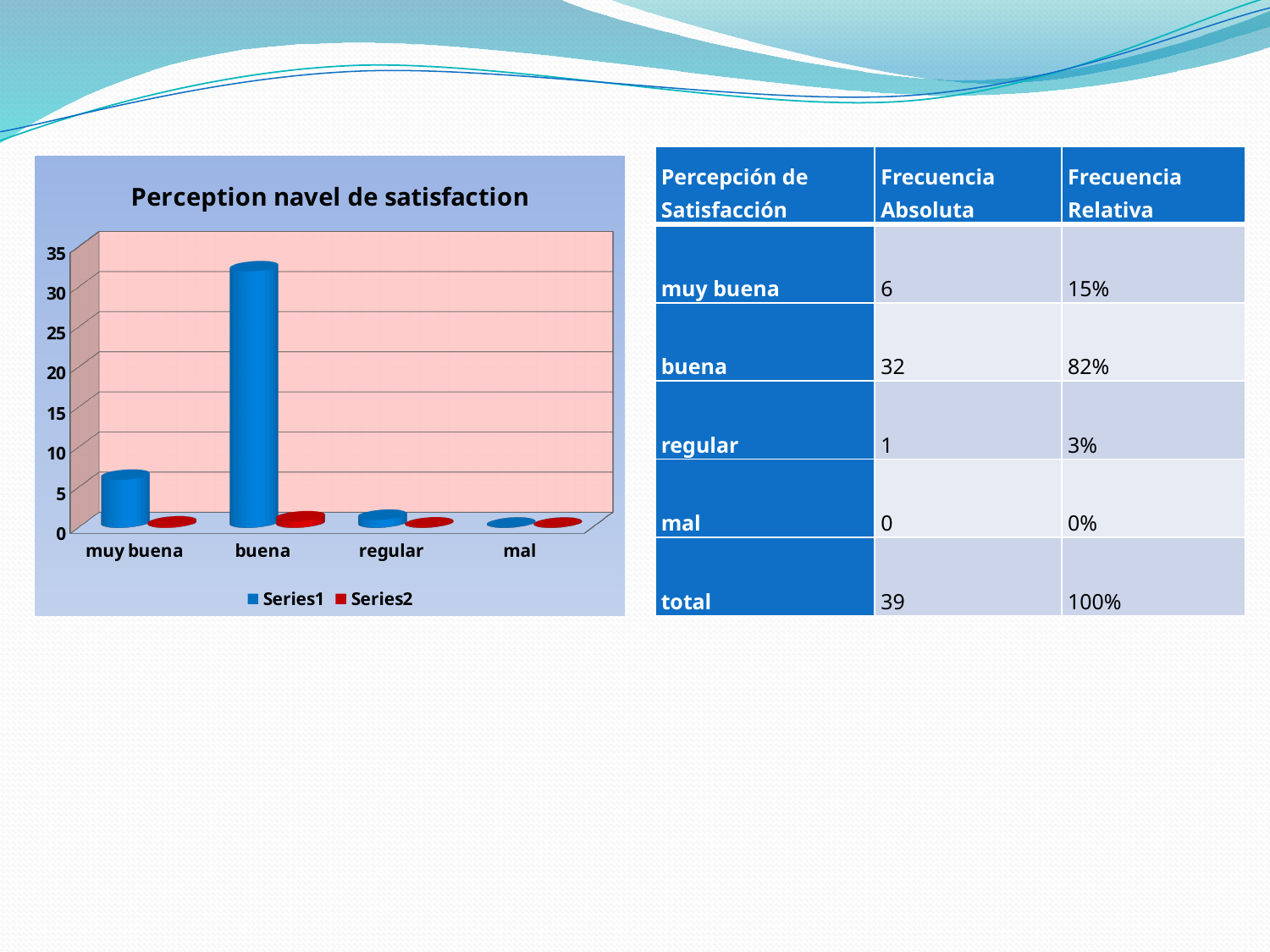
Is the Series1 value for buena greater or less than 30? greater Which category has the lowest Series1 bar in the chart? mal How many series does the chart legend list? 2 Which has a larger Series1 value, buena or muy buena? buena Which category has the highest Series1 bar in the chart? buena How many categories are shown on the x axis of the chart? 4 Which has a larger Series1 value, muy buena or regular? muy buena Is the Series1 value for regular greater or less than 5? less What type of chart is shown on the slide? bar chart What is the title of the chart? Perception navel de satisfaction Is the Series1 value for muy buena greater or less than 10? less What colour represents Series2 in the chart legend? red